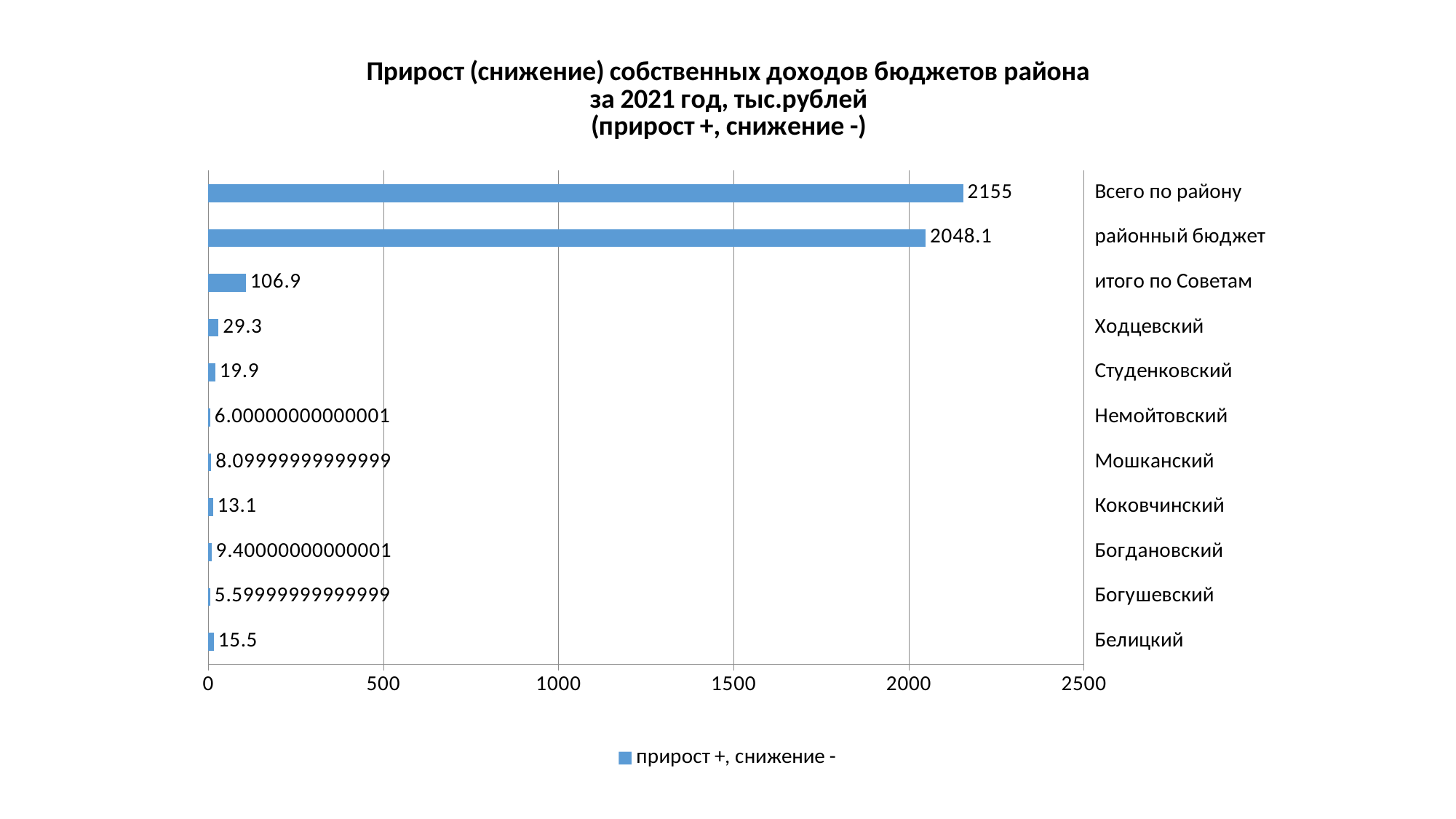
How many categories are shown in the chart? 11 What is the value for Всего по району? 2155 What is the value for Белицкий? 15.5 What kind of chart is this? Bar chart What is the value for Ходцевский? 29.3 Which category has the highest value? Всего по району Which is larger, the value for Коковчинский or the value for Белицкий? Белицкий What is the difference between the values for Ходцевский and Студенковский? 9.4 What is the value for итого по Советам? 106.9 Which category has the lowest value? Богушевский What is the value for районный бюджет? 2048.1 What is the difference between the values for Всего по району and районный бюджет? 106.9